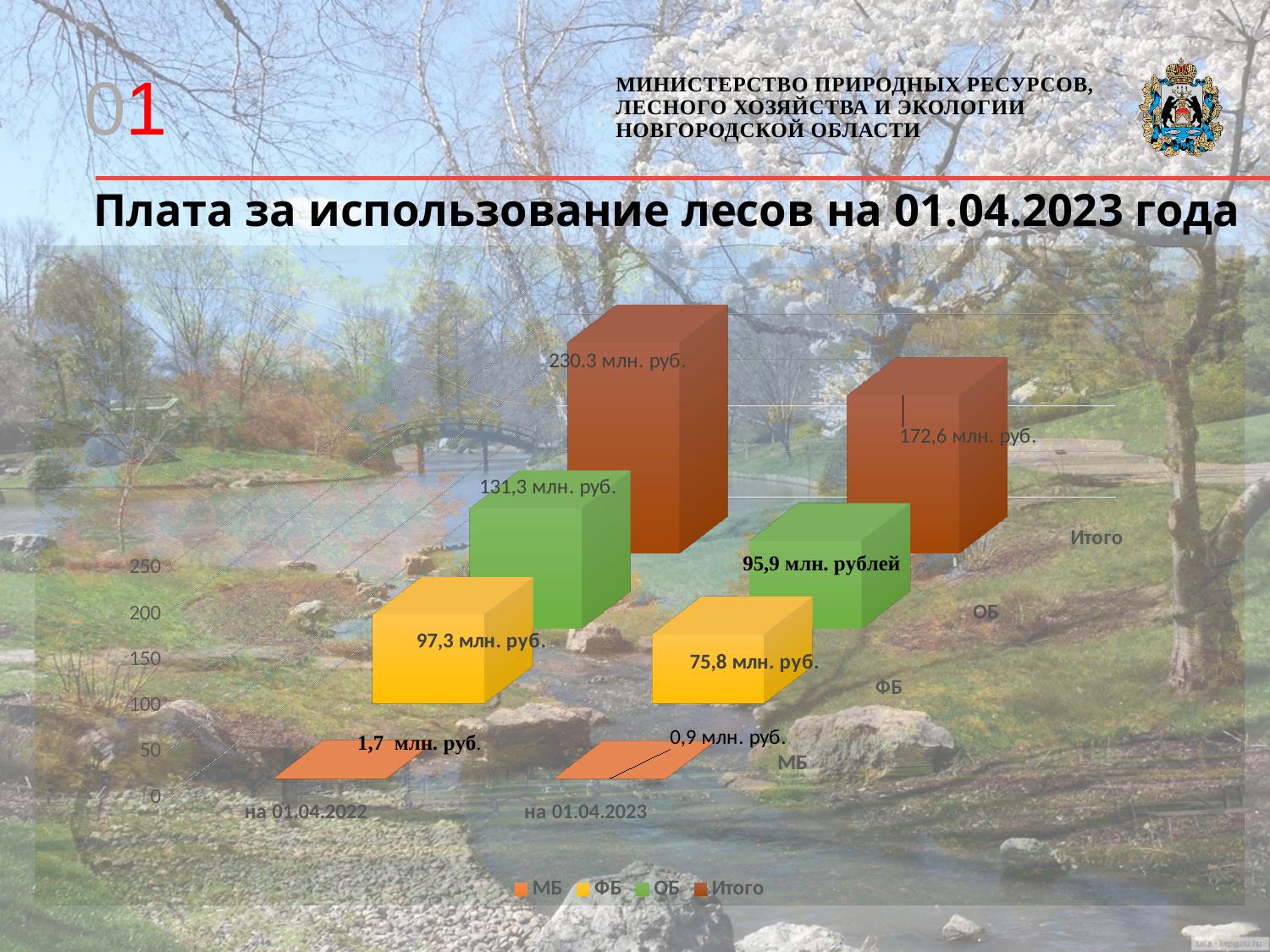
Do the ОБ values rise or fall from 01.04.2022 to 01.04.2023? Fall What is the value for ОБ on 01.04.2022? 131,3 млн. руб. What is the value for Итого on 01.04.2023? 172,6 млн. руб. What is the difference between the Итого values on 01.04.2022 and 01.04.2023? 57,7 млн. руб. How many series does the legend list? 4 What is the value for ФБ on 01.04.2023? 75,8 млн. руб. Which is larger: ФБ on 01.04.2022 or ФБ on 01.04.2023? ФБ on 01.04.2022 Which series has the highest value on 01.04.2023? Итого Which series has the lowest value on 01.04.2022? МБ What is the value for МБ on 01.04.2023? 0,9 млн. руб. What is the value for Итого on 01.04.2022? 230.3 млн. руб. What kind of chart is shown on the slide? Bar chart